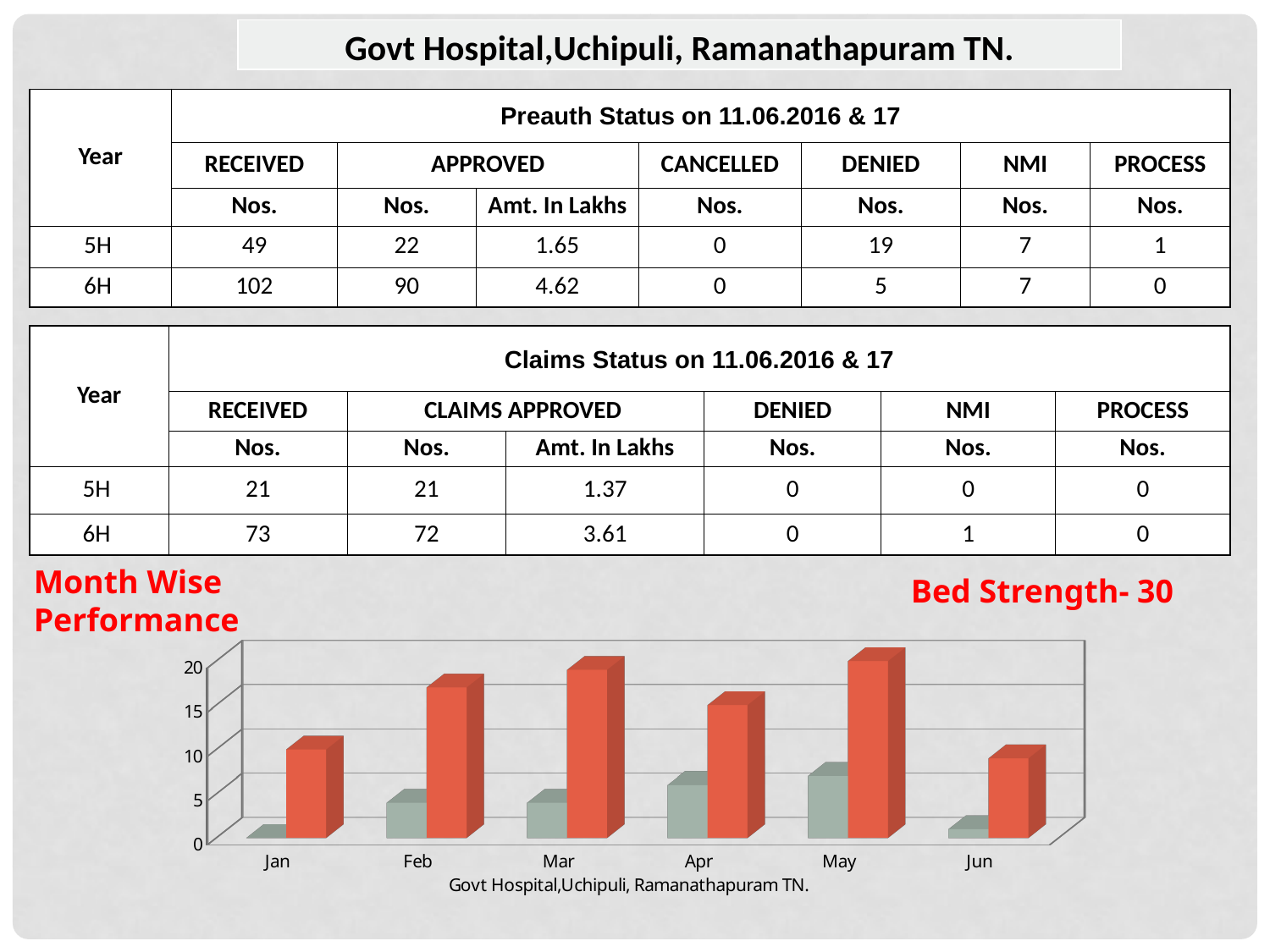
Is the red bar for May greater or less than 15? greater What kind of chart is shown under 'Month Wise Performance'? bar chart How many months are shown on the x axis of the bar chart? 6 Is the grey bar for May greater or less than 5? greater Which is larger, the grey bar for Apr or the grey bar for Jan? Apr Is the red bar for Mar greater or less than 15? greater What are the two colours of the bars in the chart? grey and red What is the title printed below the bar chart? Govt Hospital,Uchipuli, Ramanathapuram TN. Which is larger, the red bar for Mar or the red bar for Apr? Mar Which is larger, the red bar for Feb or the red bar for Jan? Feb